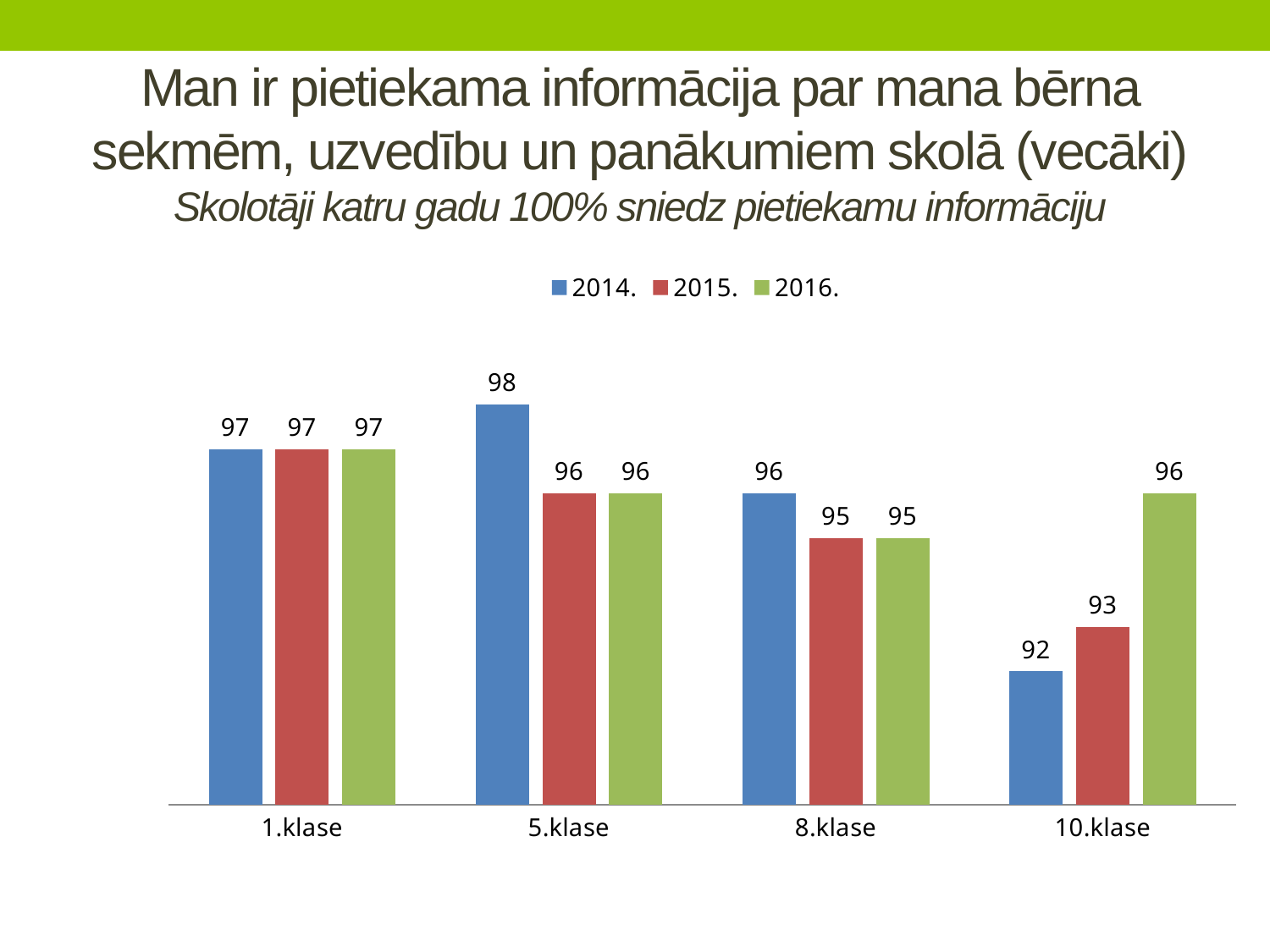
What is the value for 8.klase in 2016.? 95 Which class has the highest value in the 2014. series? 5.klase How many series does the legend list? 3 What is the value for 1.klase in 2014.? 97 What is the difference between the 2016. and 2014. values for 10.klase? 4 How many classes are shown on the x axis? 4 Which class has the lowest value in the 2014. series? 10.klase What kind of chart is shown on the slide? bar chart What is the value for 10.klase in 2015.? 93 Which is larger for 5.klase: the 2014. value or the 2015. value? 2014. Which colour represents the 2016. series in the legend? green Do the 2014. values rise or fall from 5.klase to 10.klase? fall